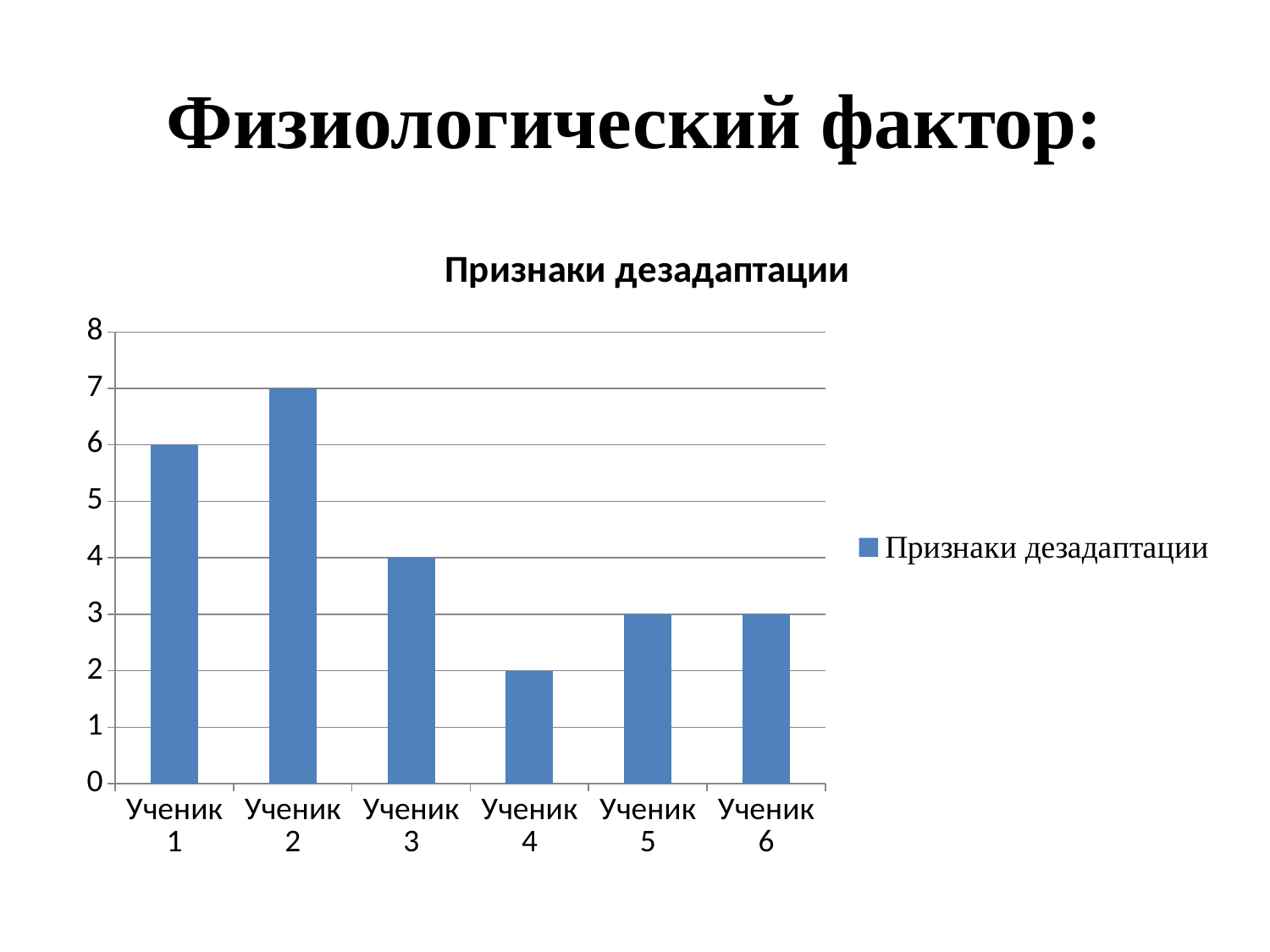
What is the value for Ученик 2? 7 How many categories are shown on the x axis? 6 What kind of chart is shown on the slide? bar chart What is the value for Ученик 3? 4 What is the value for Ученик 1? 6 What is the value for Ученик 4? 2 Is the value for Ученик 2 greater or less than 5? greater Which is larger, the value for Ученик 1 or the value for Ученик 3? Ученик 1 Which category has the highest value? Ученик 2 What is the difference between the values for Ученик 2 and Ученик 4? 5 Which category has the lowest value? Ученик 4 What is the title of the chart? Признаки дезадаптации